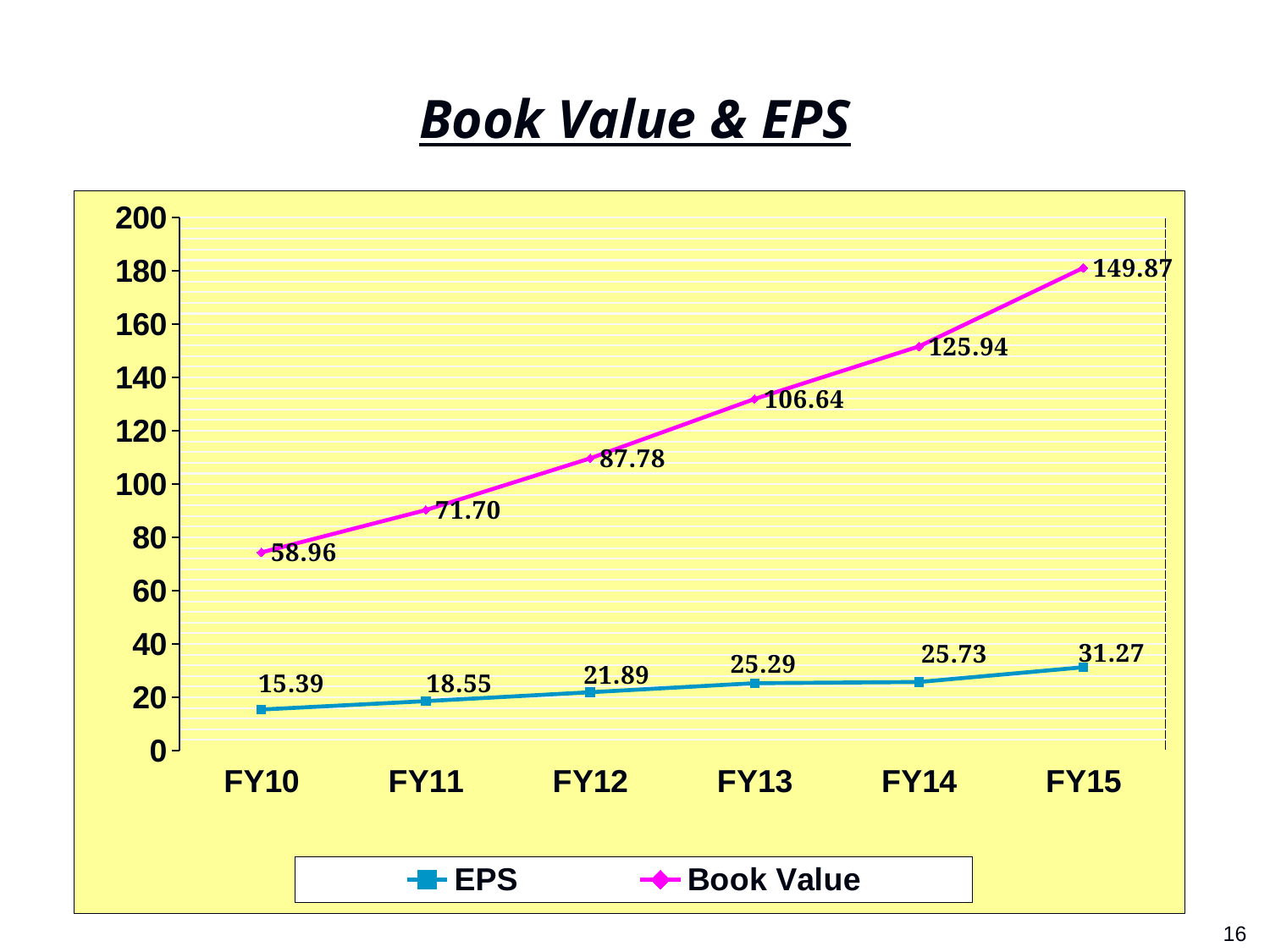
What kind of chart is shown on the slide? Line chart What is the difference between the Book Value in FY15 and the Book Value in FY14? 23.93 How many series does the legend list? 2 In which fiscal year is the Book Value highest? FY15 What is the Book Value for FY15? 149.87 Which is larger, the EPS in FY12 or the EPS in FY13? EPS in FY13 What is the EPS for FY14? 25.73 Does the Book Value rise or fall from FY10 to FY15? Rise In which fiscal year is the EPS lowest? FY10 How many fiscal years are shown on the x axis? 6 What is the EPS for FY11? 18.55 What is the Book Value for FY13? 106.64